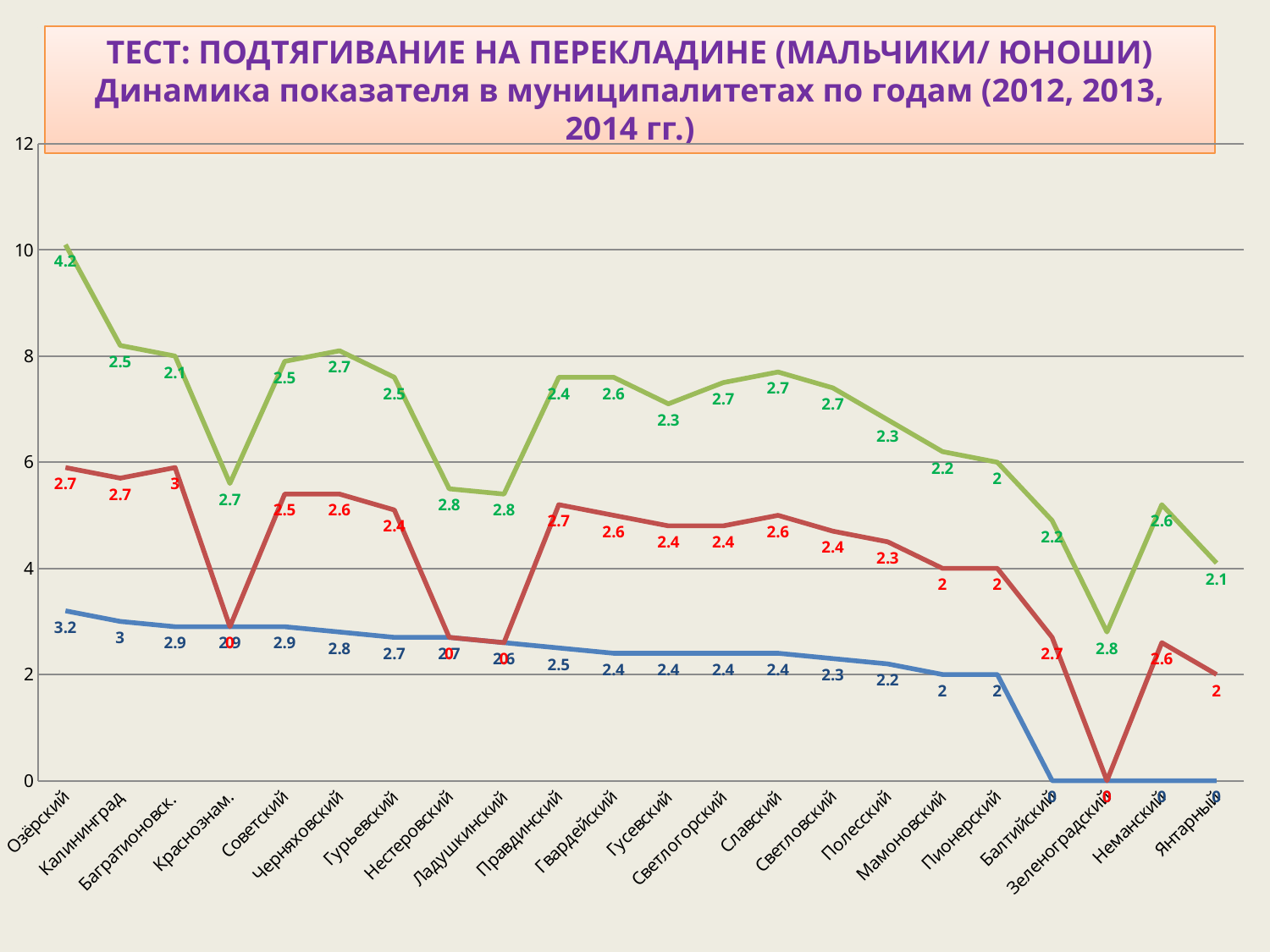
How many municipalities are listed along the x axis? 22 What kind of chart is shown on the slide? line chart What is the value labelled on the red line for Зеленоградский? 0 Which municipality has the highest labelled value on the blue line? Озёрский What is the value labelled on the green line for Янтарный? 2.1 What is the value labelled on the blue line for Калининград? 3 What is the value labelled on the green line for Озёрский? 4.2 What is the difference between the green and blue labelled values for Озёрский? 1 Which is larger for Озёрский: the green line value or the blue line value? green line value How many lines are plotted on the chart? 3 What is the value labelled on the blue line for Озёрский? 3.2 Does the blue line generally rise or fall from left to right across the municipalities? fall